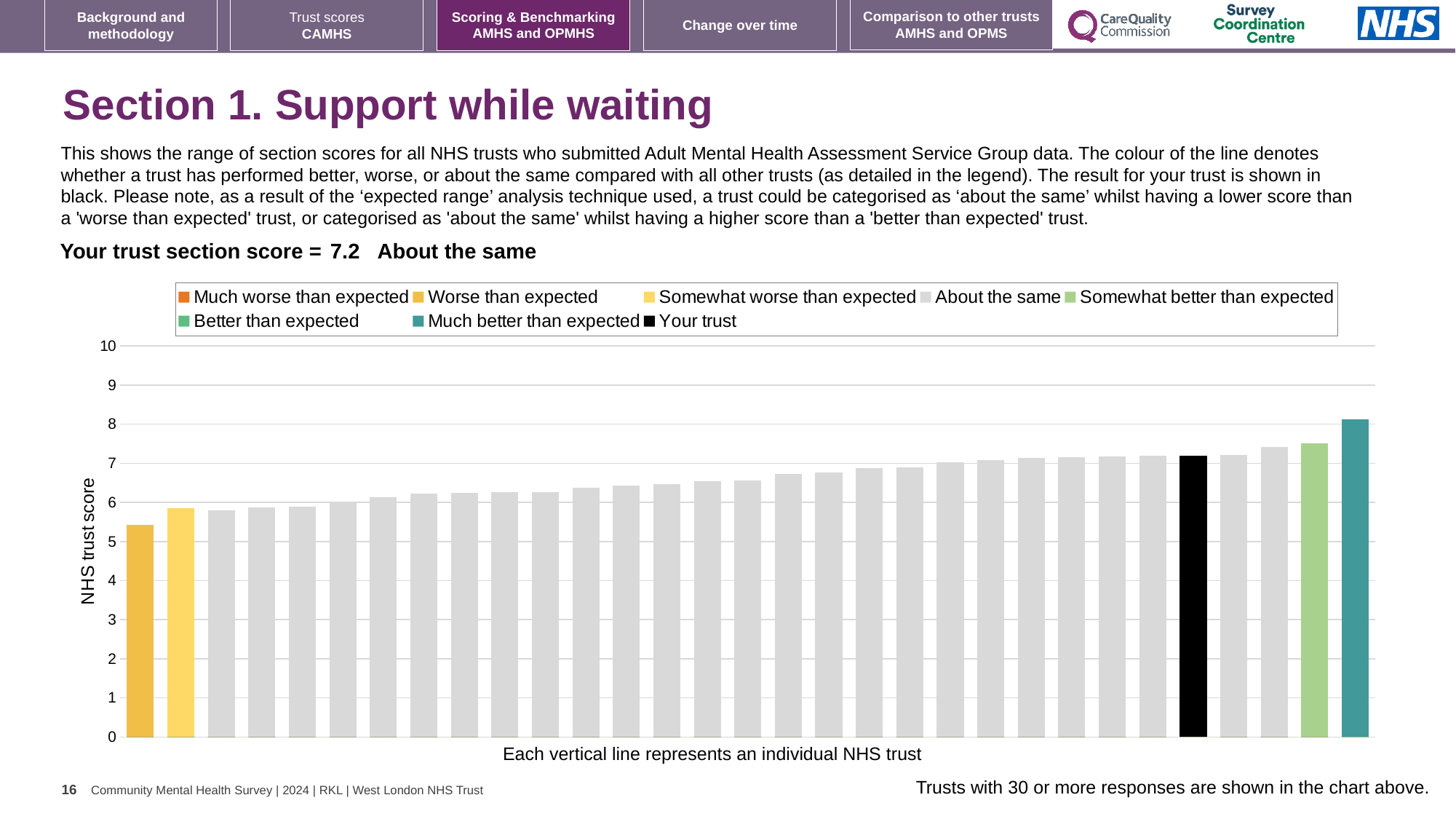
Which legend category does the tallest bar in the chart belong to? Much better than expected What colour is the bar representing your trust? Black Do the bar values rise or fall from left to right across the chart? Rise Which legend category does the shortest bar in the chart belong to? Worse than expected What kind of chart is shown on the slide? Bar chart Is the value of the shortest bar greater or less than 6? less Which is larger: the 'Your trust' bar or the 'Worse than expected' bar? Your trust Is the value of the black 'Your trust' bar greater or less than 7? greater What is the label on the vertical axis of the chart? NHS trust score How many entries does the chart legend list? 8 Is the value of the tallest bar greater or less than 7? greater What is the section score for your trust shown on the slide? 7.2